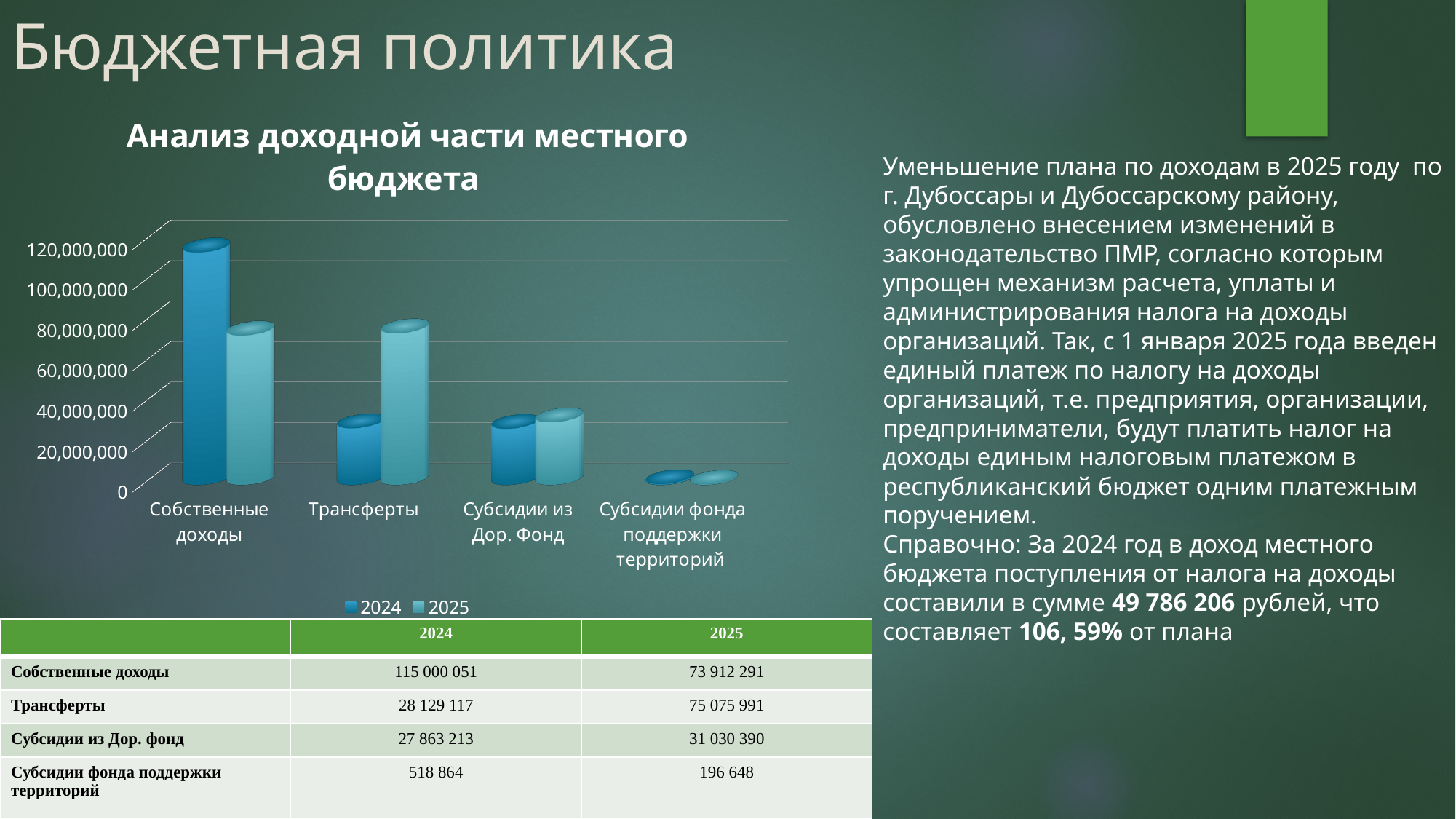
How many series does the chart legend list? 2 By how much did Собственные доходы decrease from 2024 to 2025? 41 087 760 Is the value for Собственные доходы in 2024 greater or less than 100,000,000? greater What is the value for Трансферты in 2025? 75 075 991 Which category has the lowest value for 2025? Субсидии фонда поддержки территорий How many categories are shown on the x axis of the chart? 4 What is the value for Субсидии фонда поддержки территорий in 2025? 196 648 What is the value for Собственные доходы in 2024? 115 000 051 Which category has the highest value for 2024? Собственные доходы What is the title of the chart on the slide? Анализ доходной части местного бюджета What kind of chart is shown on the slide? bar chart Which is larger for Трансферты: the 2024 value or the 2025 value? 2025